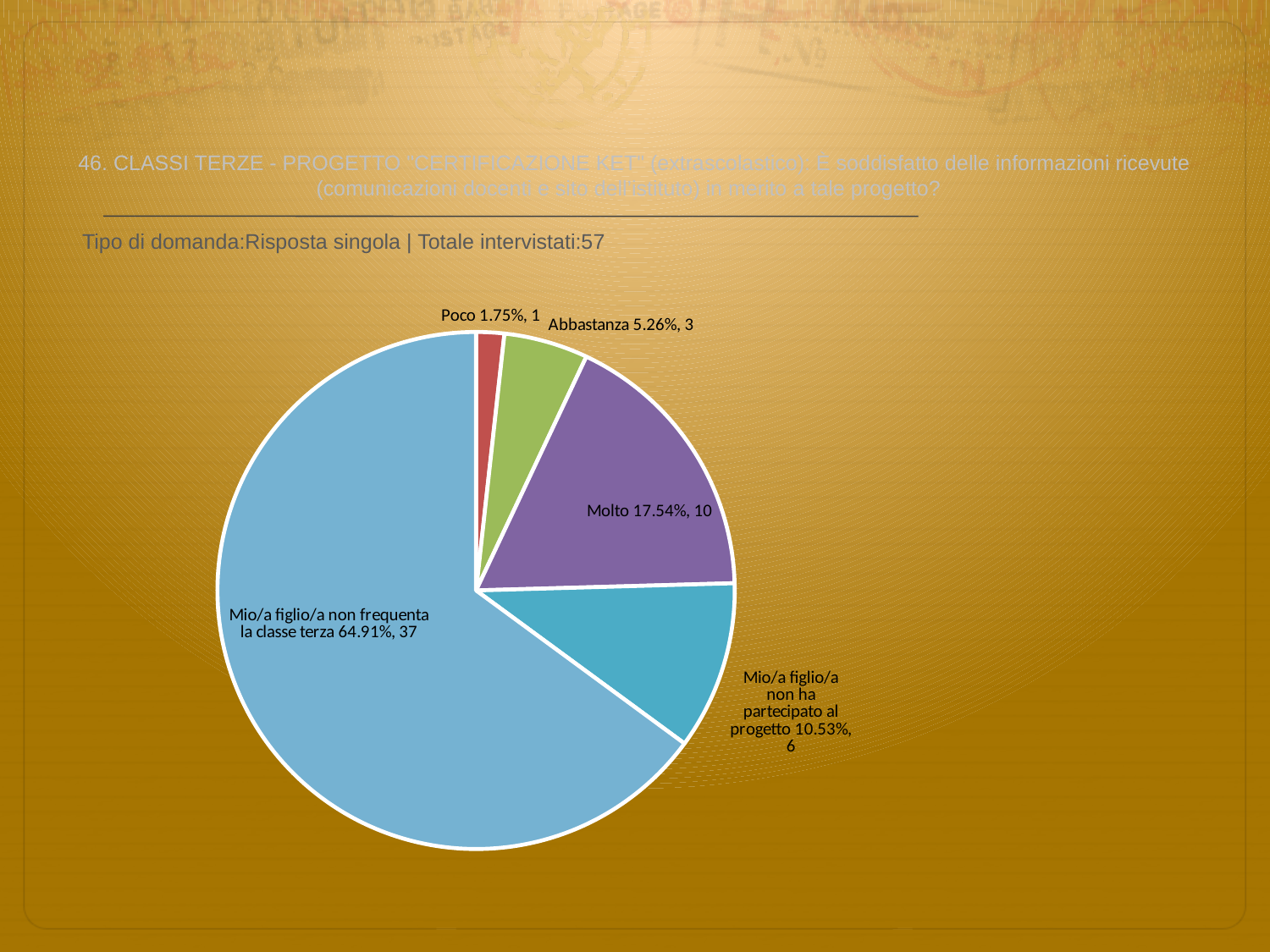
What percentage is shown for "Mio/a figlio/a non ha partecipato al progetto"? 10.53% What percentage is shown for "Abbastanza"? 5.26% What is the count for "Molto"? 10 Which category has the smallest slice? Poco What is the total number of respondents stated on the slide? 57 Which is larger, the slice for "Abbastanza" or the slice for "Molto"? Molto How many slices does the pie chart have? 5 What is the difference in count between "Molto" and "Mio/a figlio/a non ha partecipato al progetto"? 4 What is the count for "Poco"? 1 Which category has the largest slice? Mio/a figlio/a non frequenta la classe terza What share of the pie does "Mio/a figlio/a non frequenta la classe terza" represent? 64.91% What kind of chart is shown on the slide? pie chart